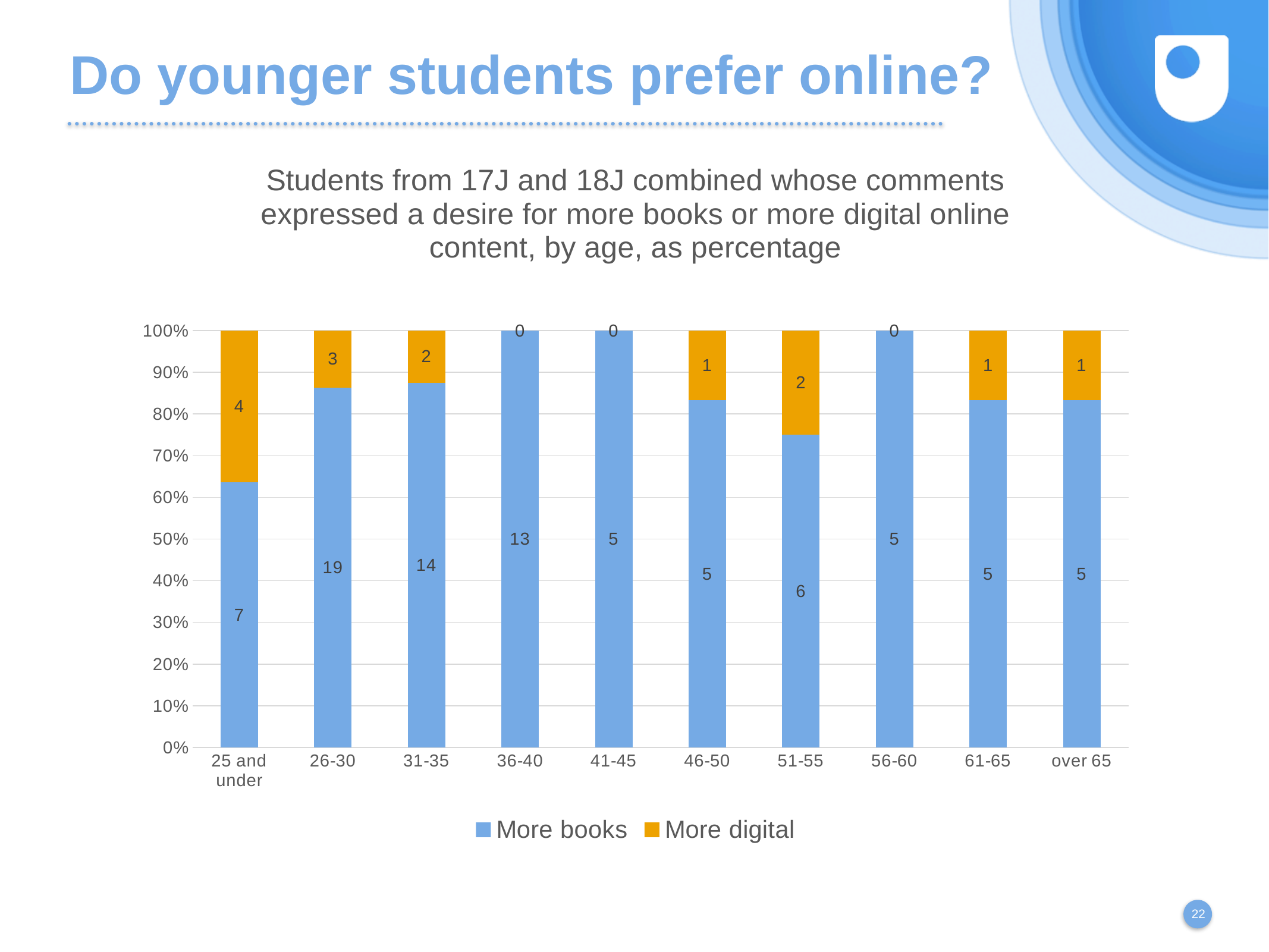
What is the data label for More books in the 26-30 age group? 19 Is the More books share of the bar for 25 and under greater or less than 70%? less What is the data label for More digital in the 25 and under age group? 4 Which age group has the highest More books data label? 26-30 Which is larger, the More digital data label for 26-30 or for 51-55? 26-30 How many age groups are shown on the x axis? 10 What is the total of the data labels in the 25 and under bar? 11 How many series does the legend list? 2 What kind of chart is shown on the slide? stacked bar chart Which age group has the highest More digital data label? 25 and under What is the data label for More books in the 36-40 age group? 13 What is the difference between the More books data labels for 26-30 and 31-35? 5